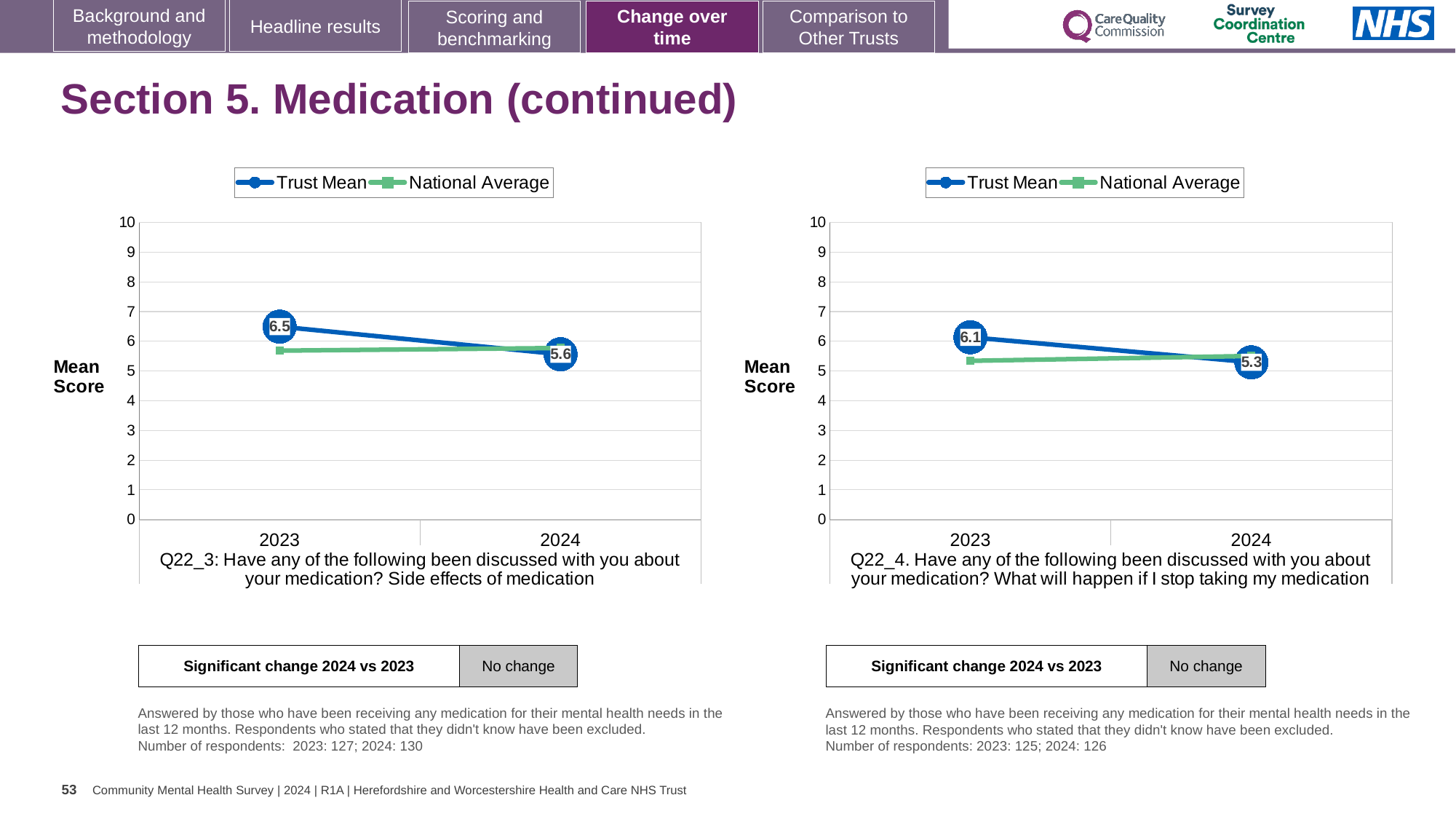
In the right chart (Q22_4), does the Trust Mean rise or fall from 2023 to 2024? fall In the left chart (Q22_3), does the Trust Mean rise or fall from 2023 to 2024? fall In the left chart (Q22_3), by how much did the Trust Mean fall from 2023 to 2024? 0.9 How many series does the legend of the left chart (Q22_3) list? 2 What kind of chart is the right chart (Q22_4)? line chart In the left chart (Q22_3), what is the Trust Mean score for 2024? 5.6 In the right chart (Q22_4), what is the difference between the Trust Mean in 2023 and in 2024? 0.8 In the left chart (Q22_3), what is the Trust Mean score for 2023? 6.5 In the right chart (Q22_4), what is the Trust Mean score for 2023? 6.1 In the left chart (Q22_3), which is larger in 2023: the Trust Mean or the National Average? Trust Mean In the left chart (Q22_3), is the National Average value for 2023 greater or less than 6? less In the right chart (Q22_4), what is the Trust Mean score for 2024? 5.3